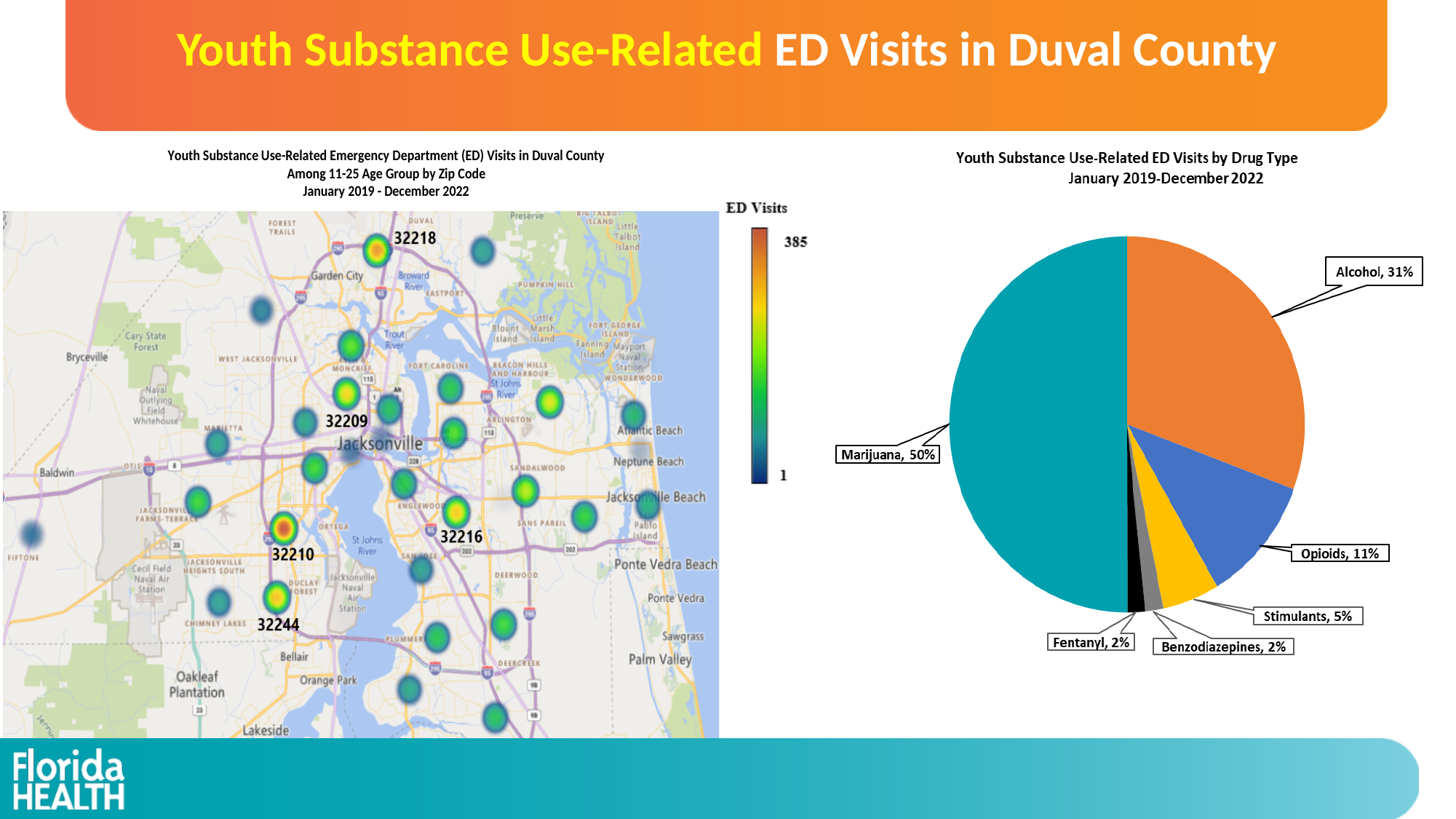
What is the title of the chart on the right side of the slide? Youth Substance Use-Related ED Visits by Drug Type January 2019-December 2022 How many drug-type slices does the pie chart on the right show? 6 What kind of chart is used on the right side of the slide to show ED visits by drug type? Pie chart In the pie chart on the right, how many percentage points larger is the Alcohol share than the Opioids share? 20 percentage points In the pie chart on the right, which is larger: the share for Alcohol or the share for Opioids? Alcohol In the pie chart 'Youth Substance Use-Related ED Visits by Drug Type', what share of visits is attributed to Marijuana? 50% What is the maximum value shown on the 'ED Visits' colour scale next to the map? 385 In the pie chart on the right, what percentage of ED visits is attributed to Stimulants? 5% In the pie chart on the right, how many percentage points larger is the Marijuana share than the Alcohol share? 19 percentage points In the pie chart on the right, what percentage of ED visits is attributed to Opioids? 11% In the pie chart on the right, what percentage of ED visits is attributed to Alcohol? 31% In the pie chart on the right, which drug type accounts for the largest share of ED visits? Marijuana